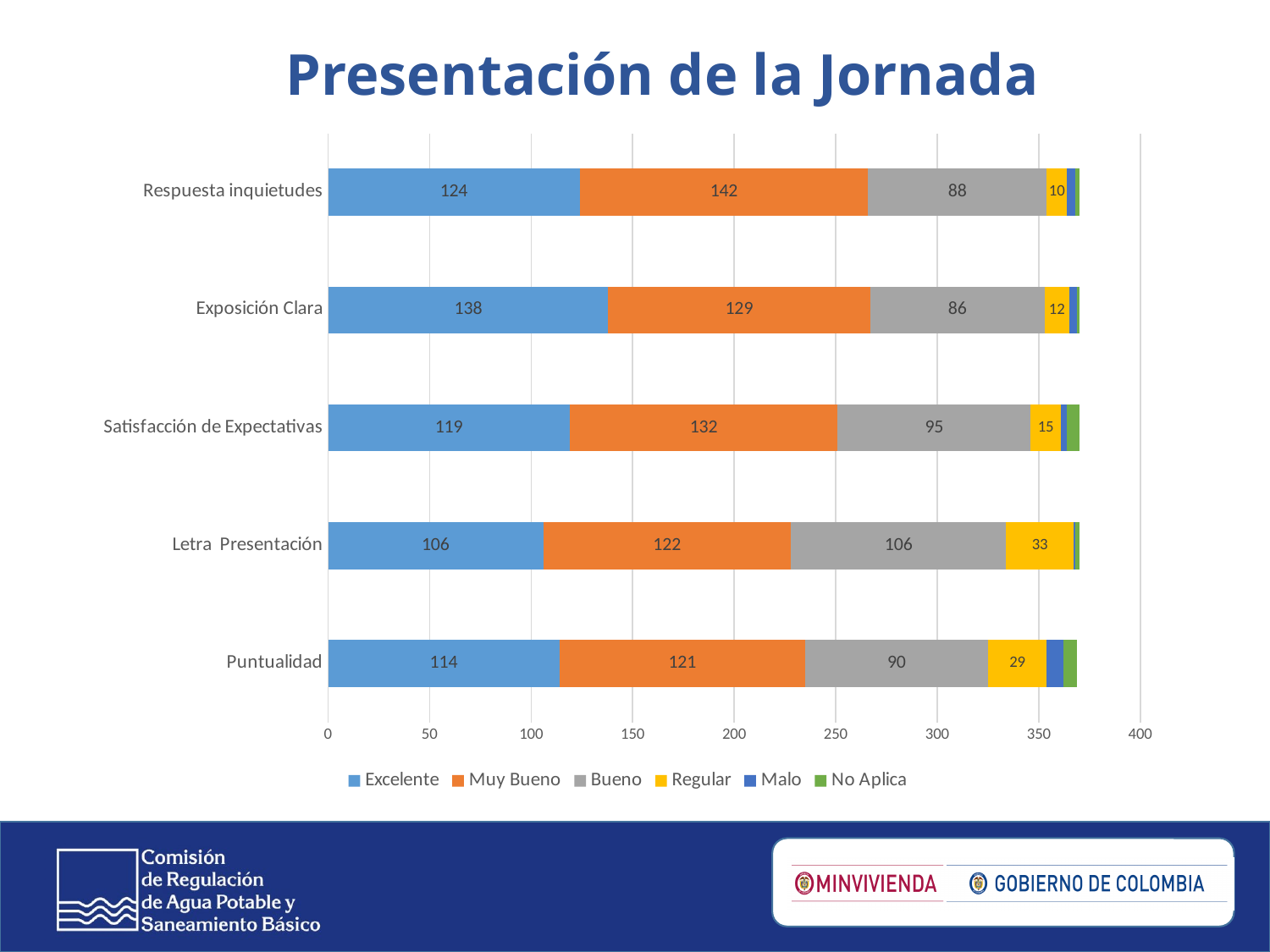
Which category has the lowest Excelente value? Letra Presentación What is the Bueno value for Satisfacción de Expectativas? 95 How many series does the legend list? 6 What is the Regular value for Letra Presentación? 33 What is the Excelente value for Exposición Clara? 138 How many categories are shown on the y axis? 5 Which is larger, the Bueno value for Letra Presentación or the Bueno value for Puntualidad? Letra Presentación What is the title of the slide? Presentación de la Jornada What is the Muy Bueno value for Respuesta inquietudes? 142 Which category has the highest Excelente value? Exposición Clara What is the difference between the Muy Bueno values for Respuesta inquietudes and Puntualidad? 21 What kind of chart is shown on the slide? Stacked bar chart